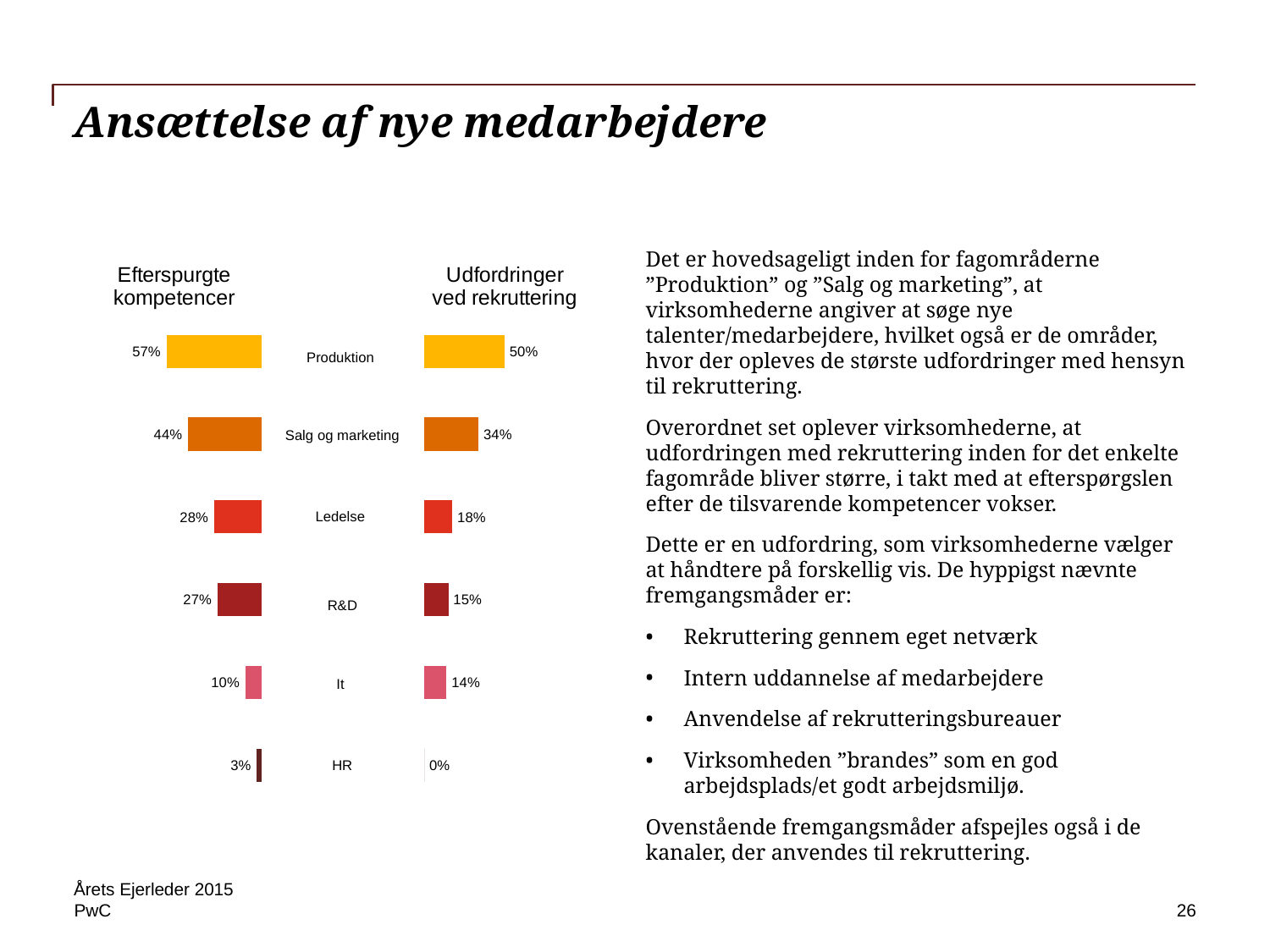
What kind of chart is used for "Udfordringer ved rekruttering"? bar chart In the "Efterspurgte kompetencer" chart, what is the difference between the values for Produktion and Salg og marketing? 13% In the "Udfordringer ved rekruttering" chart, which category has the lowest value? HR In the "Efterspurgte kompetencer" chart, which category has the highest value? Produktion In the "Udfordringer ved rekruttering" chart, which is larger: the value for Ledelse or the value for R&D? Ledelse Is the value for Ledelse in the "Efterspurgte kompetencer" chart larger or smaller than the value for Ledelse in the "Udfordringer ved rekruttering" chart? larger In the "Efterspurgte kompetencer" chart, what is the value for HR? 3% In the "Efterspurgte kompetencer" chart, what is the value for Produktion? 57% How many categories are shown in the "Efterspurgte kompetencer" chart? 6 In the "Udfordringer ved rekruttering" chart, what is the value for Salg og marketing? 34% In the "Udfordringer ved rekruttering" chart, what is the value for It? 14% What is the difference between the Produktion value in the "Efterspurgte kompetencer" chart and the Produktion value in the "Udfordringer ved rekruttering" chart? 7%